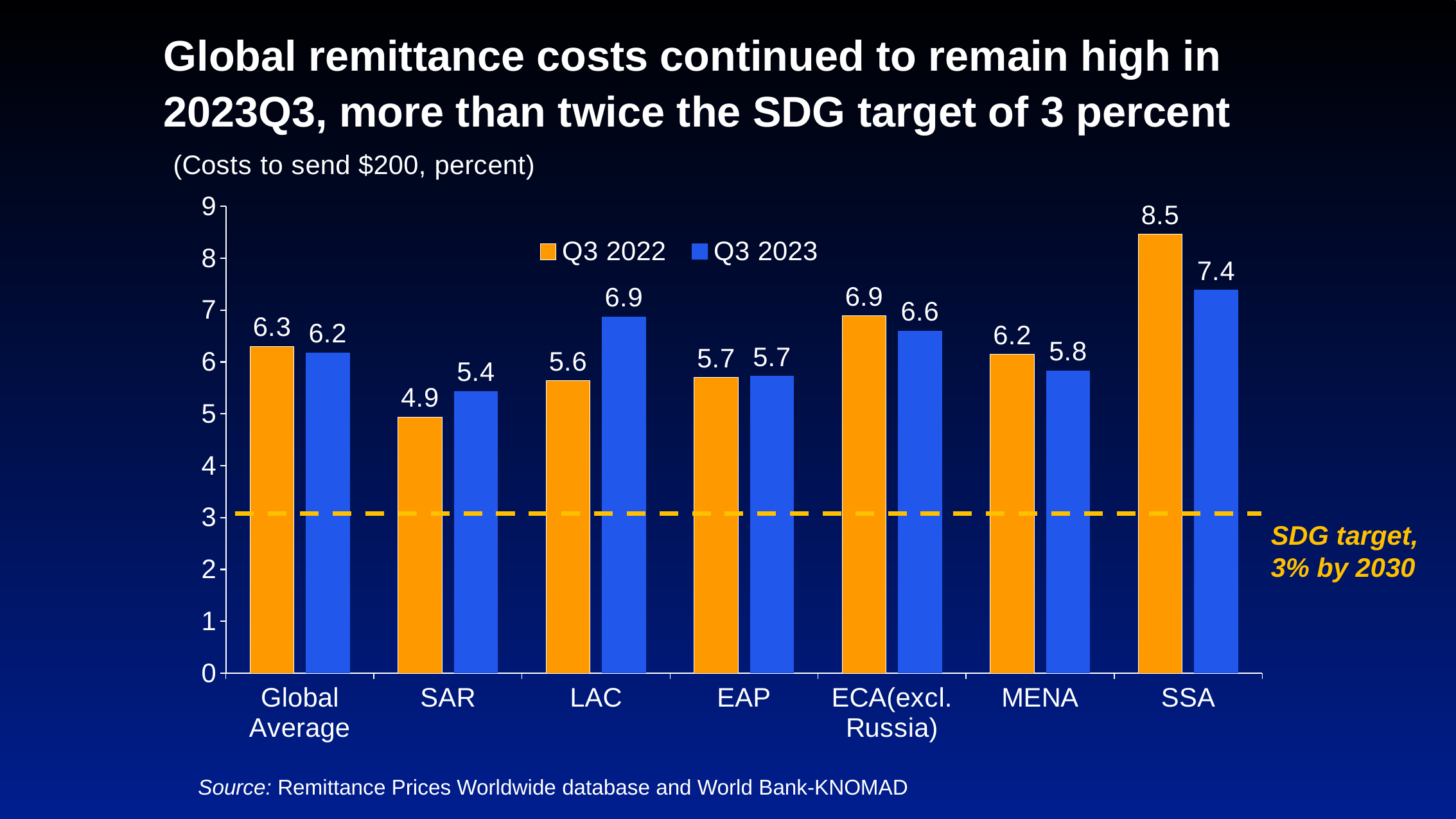
What kind of chart is shown on the slide? Bar chart What is the Q3 2023 value for the Global Average? 6.2 How many series does the legend list? 2 What does the dashed horizontal line on the chart represent? SDG target, 3% by 2030 What is the Q3 2023 value for SSA? 7.4 What is the Q3 2022 value for SAR? 4.9 How many regions/categories are shown on the x axis? 7 Which is larger for LAC: the Q3 2022 value or the Q3 2023 value? Q3 2023 What is the difference between the Q3 2022 and Q3 2023 values for SSA? 1.1 Is the Q3 2023 value for ECA(excl. Russia) greater or less than 6? greater Which region has the lowest Q3 2023 value? SAR Which region has the highest Q3 2022 value? SSA